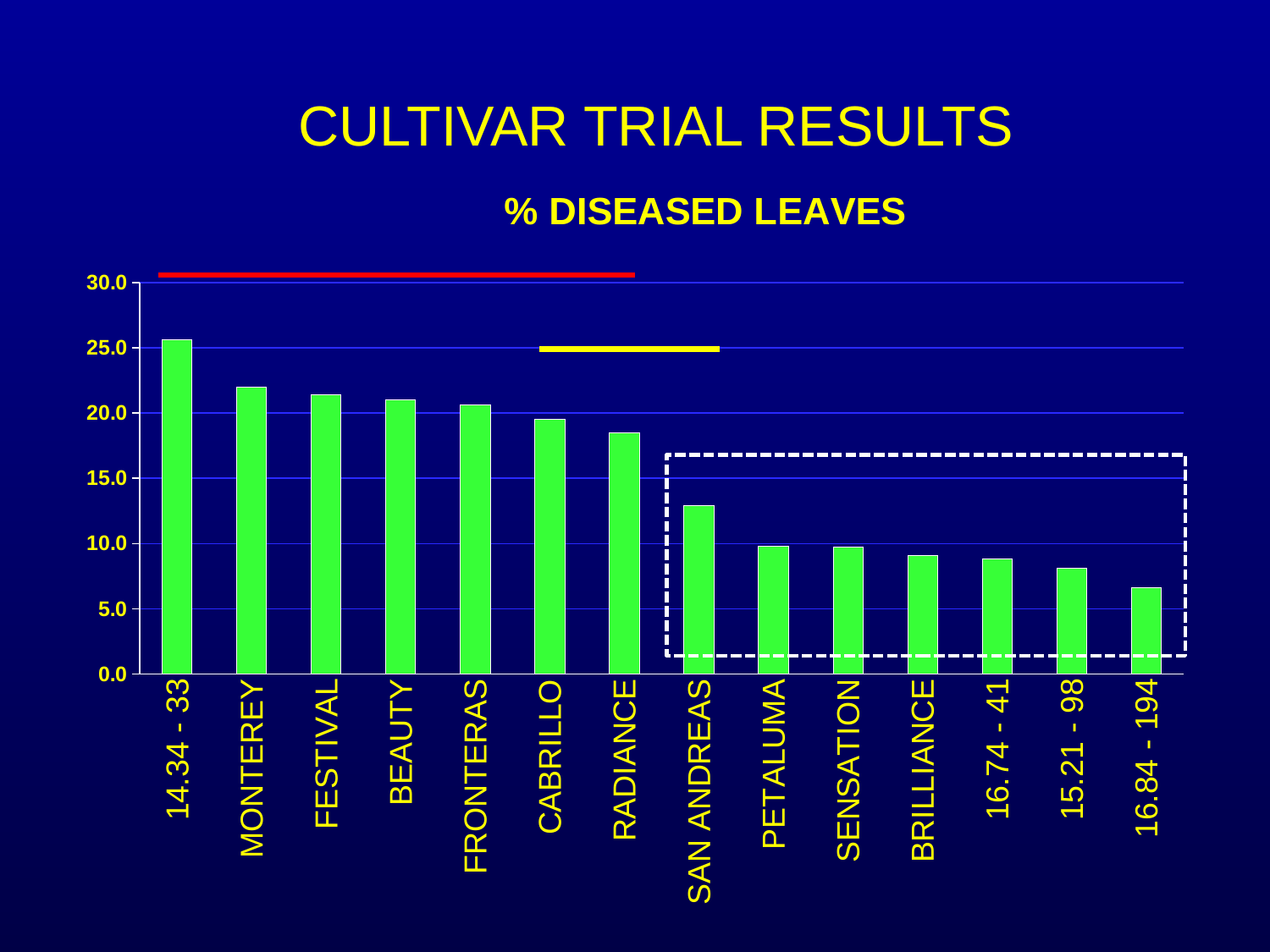
Which has a lower % diseased leaves, RADIANCE or 15.21 - 98? 15.21 - 98 Is the value for 14.34 - 33 greater or less than 25.0? greater Which cultivar has the lowest % diseased leaves? 16.84 - 194 Which cultivar has the highest % diseased leaves? 14.34 - 33 How many cultivars are plotted on the chart? 14 What kind of chart is shown on the slide? bar chart Is the value for SAN ANDREAS greater or less than 15.0? less Which has a higher % diseased leaves, FESTIVAL or BRILLIANCE? FESTIVAL Is the value for MONTEREY greater or less than 20.0? greater What is the subtitle shown above the chart? % DISEASED LEAVES Do the values rise or fall moving from left to right along the x axis? fall